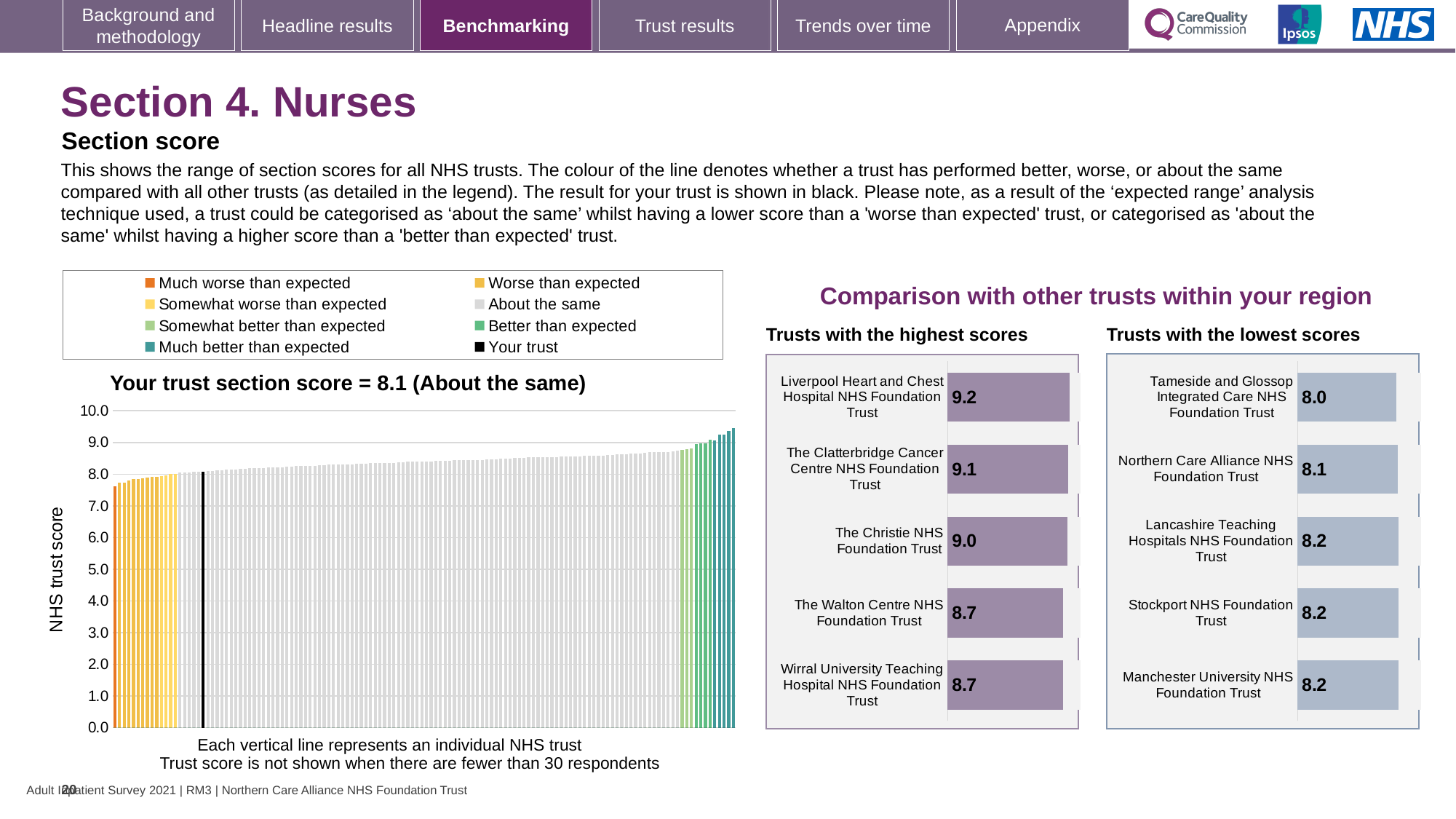
In the 'Your trust section score' chart on the left, is the value of the highest bar greater or less than 9.0? greater In the 'Trusts with the lowest scores' chart, which trust has the lowest score? Tameside and Glossop Integrated Care NHS Foundation Trust In the 'Your trust section score' chart on the left, what kind of chart is shown? bar chart In the 'Trusts with the lowest scores' chart, how many trusts are listed? 5 In the 'Your trust section score' chart on the left, what is the section score for your trust? 8.1 In the 'Trusts with the lowest scores' chart, which has the larger score: Northern Care Alliance NHS Foundation Trust or Tameside and Glossop Integrated Care NHS Foundation Trust? Northern Care Alliance NHS Foundation Trust In the 'Your trust section score' chart on the left, what is the label on the vertical axis? NHS trust score In the 'Trusts with the highest scores' chart, what is the score for The Christie NHS Foundation Trust? 9.0 In the 'Your trust section score' chart on the left, do the trust scores rise or fall from left to right? rise In the 'Trusts with the highest scores' chart, what is the difference between the scores of Liverpool Heart and Chest Hospital NHS Foundation Trust and The Walton Centre NHS Foundation Trust? 0.5 In the 'Your trust section score' chart on the left, how many entries does the legend list? 8 In the 'Trusts with the highest scores' chart, which trust has the highest score? Liverpool Heart and Chest Hospital NHS Foundation Trust